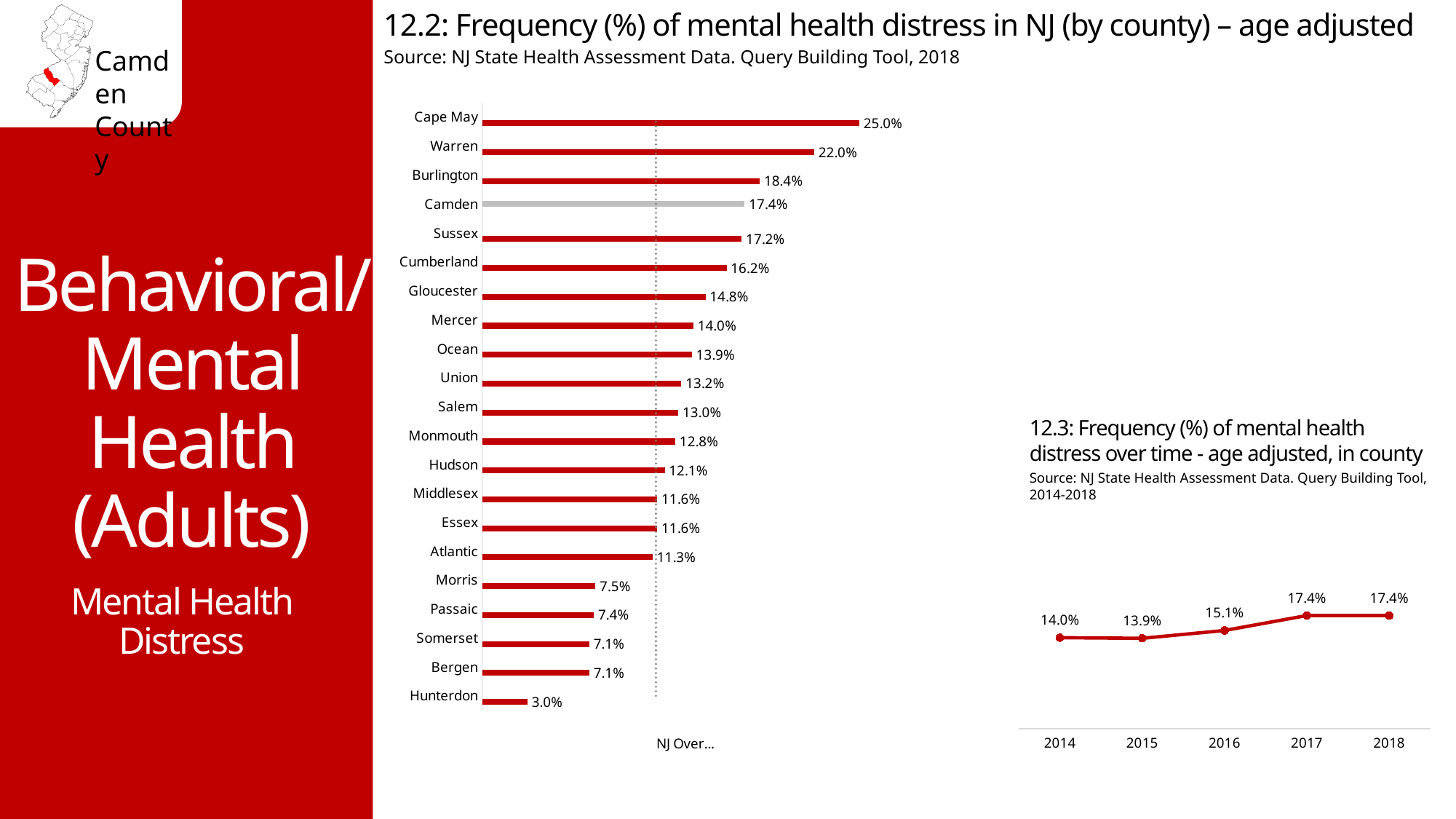
In chart 12.3 (mental health distress over time), what is the value for 2016? 15.1% In chart 12.2 (frequency of mental health distress by county), what is the difference between Cape May and Warren? 3.0% In chart 12.2 (frequency of mental health distress by county), what is the value for Gloucester? 14.8% In chart 12.3 (mental health distress over time), what is the difference between the 2018 value and the 2014 value? 3.4% In chart 12.2 (frequency of mental health distress by county), which county has the highest value? Cape May In chart 12.2 (frequency of mental health distress by county), what is the value for Camden? 17.4% In chart 12.3 (mental health distress over time), do the values generally rise or fall from 2014 to 2018? Rise In chart 12.3 (mental health distress over time), which year has the lowest value? 2015 What kind of chart is chart 12.2 (frequency of mental health distress by county)? Bar chart In chart 12.2 (frequency of mental health distress by county), how many counties are shown? 21 In chart 12.2 (frequency of mental health distress by county), which county has the lowest value? Hunterdon In chart 12.2 (frequency of mental health distress by county), which is larger, the value for Burlington or the value for Sussex? Burlington